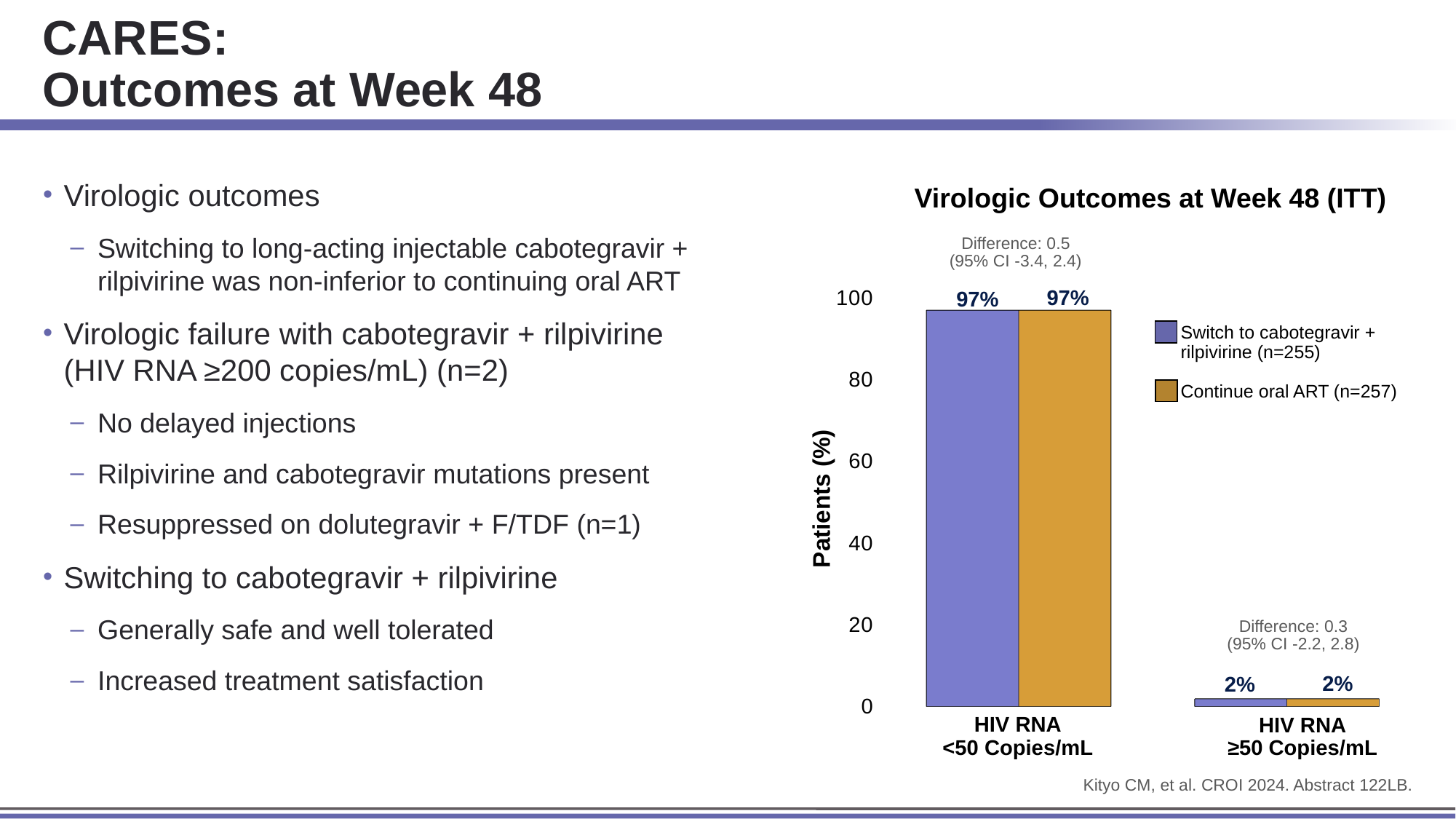
What is the title of the chart? Virologic Outcomes at Week 48 (ITT) What percentage of patients who switched to cabotegravir + rilpivirine had HIV RNA <50 copies/mL at week 48? 97% What is the difference between the two groups' values for HIV RNA <50 copies/mL? 0.5 What kind of chart is shown on the slide? Bar chart Is the value for the switch group with HIV RNA <50 copies/mL greater or less than 80? greater What percentage of patients who continued oral ART had HIV RNA ≥50 copies/mL at week 48? 2% How many series does the legend list? 2 What percentage of patients who continued oral ART had HIV RNA <50 copies/mL? 97% Is the value for the continue oral ART group with HIV RNA ≥50 copies/mL greater or less than 20? less What percentage of patients who switched to cabotegravir + rilpivirine had HIV RNA ≥50 copies/mL? 2% Which category has the lower values, HIV RNA <50 copies/mL or HIV RNA ≥50 copies/mL? HIV RNA ≥50 Copies/mL How many categories are shown on the x axis of the chart? 2